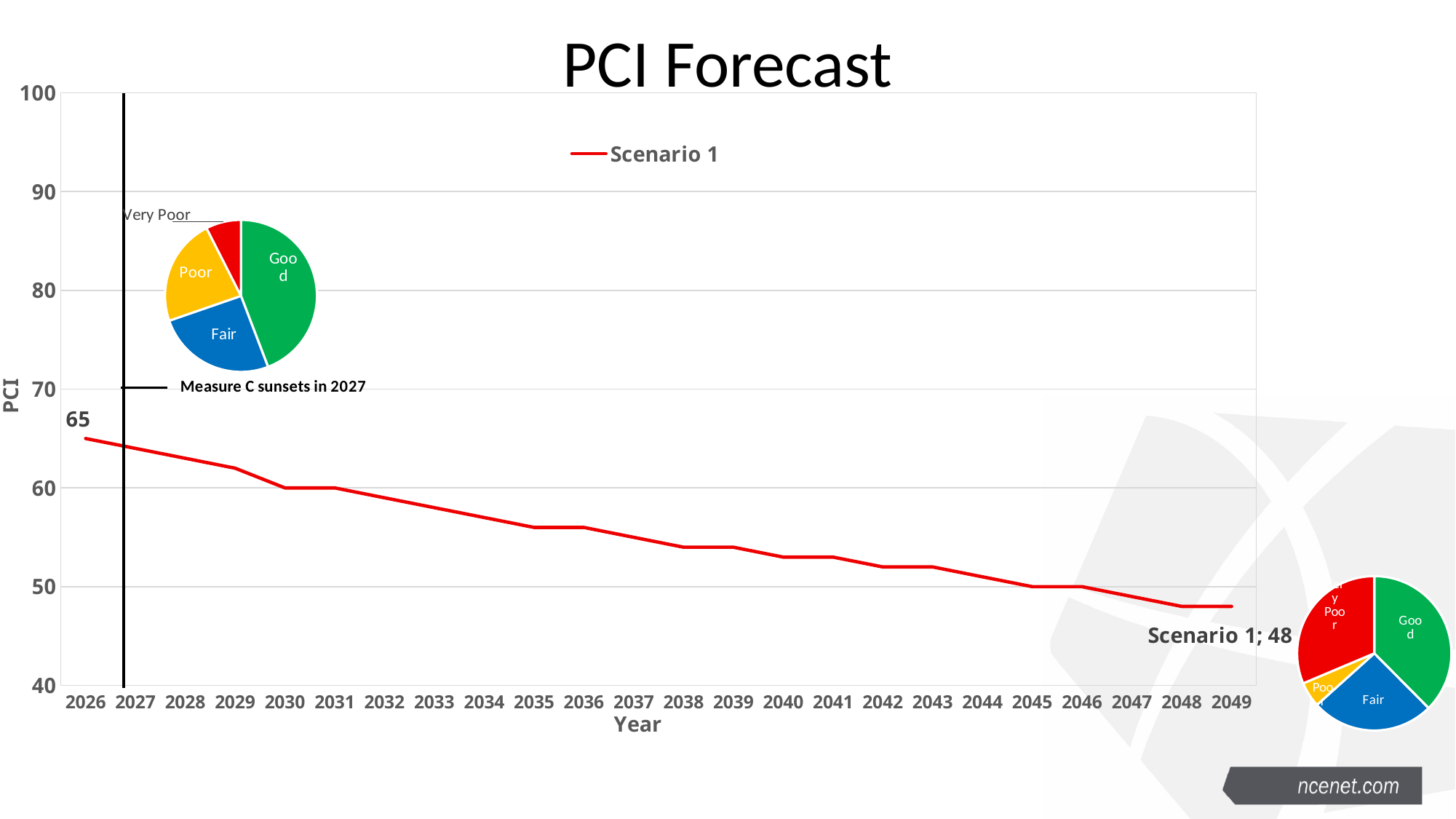
How many years are shown on the x axis of the PCI Forecast line chart? 24 In the PCI Forecast line chart, which year has the highest Scenario 1 PCI value? 2026 What kind of chart is the main PCI Forecast chart? line chart In the pie chart on the right of the slide, which slice is the smallest? Poor How many series does the legend of the PCI Forecast line chart list? 1 In the PCI Forecast line chart, does the Scenario 1 PCI rise or fall from 2026 to 2049? fall In the PCI Forecast line chart, what is the PCI value for Scenario 1 in 2049? 48 In the PCI Forecast line chart, is the Scenario 1 value for 2035 greater or less than 60? less In the PCI Forecast line chart, what is the PCI value for Scenario 1 in 2026? 65 In the PCI Forecast line chart, is the Scenario 1 value for 2040 greater or less than 50? greater In the pie chart on the left of the slide, which slice is the largest? Good In the PCI Forecast line chart, by how much does the Scenario 1 PCI fall from 2026 to 2049? 17